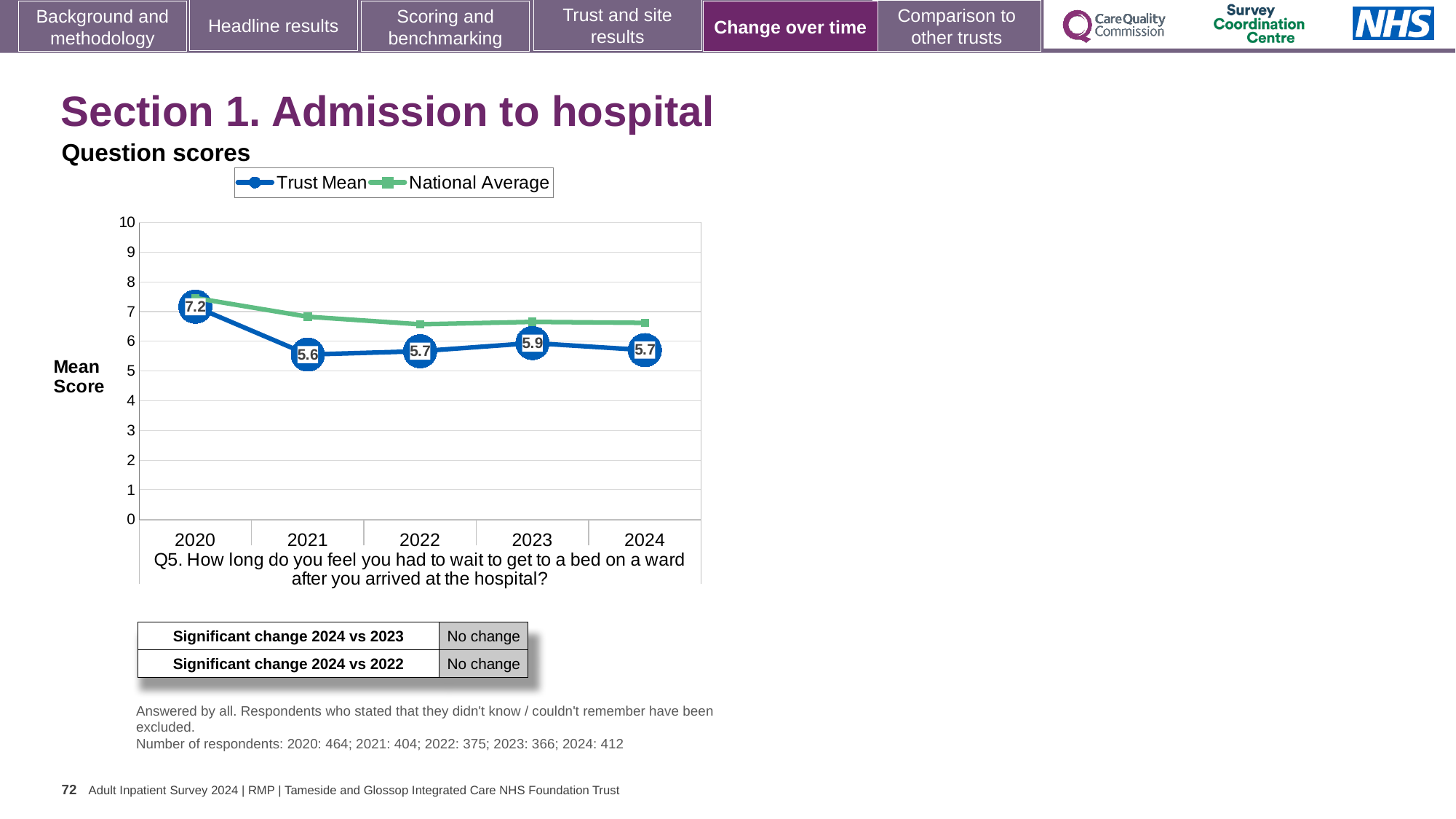
Is the National Average for 2021 greater or less than 6? greater Does the Trust Mean rise or fall from 2020 to 2021? Fall Which is larger, the Trust Mean in 2023 or in 2024? 2023 What is the Trust Mean score for 2020? 7.2 What is the difference between the Trust Mean in 2020 and in 2021? 1.6 What kind of chart is shown? Line chart How many series does the legend list? 2 What is the Trust Mean score for 2024? 5.7 In which year is the Trust Mean lowest? 2021 How many years are shown on the x axis? 5 What is the Trust Mean score for 2023? 5.9 In which year is the Trust Mean highest? 2020